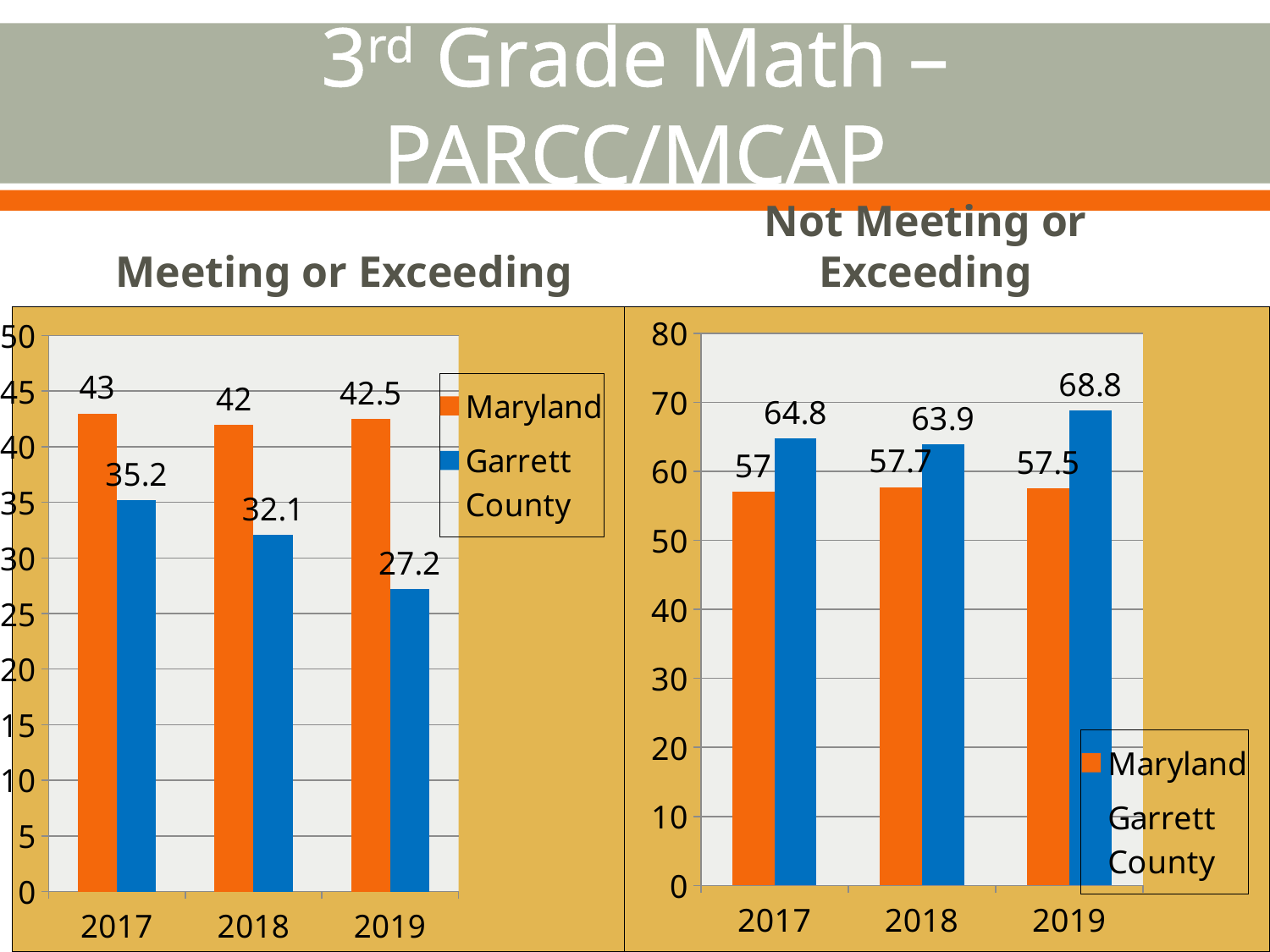
In the 'Meeting or Exceeding' chart, do the Garrett County values rise or fall from 2017 to 2019? fall In the 'Not Meeting or Exceeding' chart, what is the value for Maryland in 2018? 57.7 In the 'Not Meeting or Exceeding' chart, what is the difference between Garrett County and Maryland in 2017? 7.8 In the 'Not Meeting or Exceeding' chart, which year has the highest value for Garrett County? 2019 In the 'Meeting or Exceeding' chart, which is larger in 2018: Maryland or Garrett County? Maryland How many series does the legend list in the 'Not Meeting or Exceeding' chart? 2 In the 'Meeting or Exceeding' chart, what is the difference between Maryland and Garrett County in 2019? 15.3 In the 'Not Meeting or Exceeding' chart, what is the value for Garrett County in 2019? 68.8 In the 'Meeting or Exceeding' chart, what is the value for Garrett County in 2017? 35.2 In the 'Meeting or Exceeding' chart, which year has the lowest value for Garrett County? 2019 In the 'Meeting or Exceeding' chart, what is the value for Maryland in 2019? 42.5 What kind of chart is the 'Meeting or Exceeding' chart? bar chart